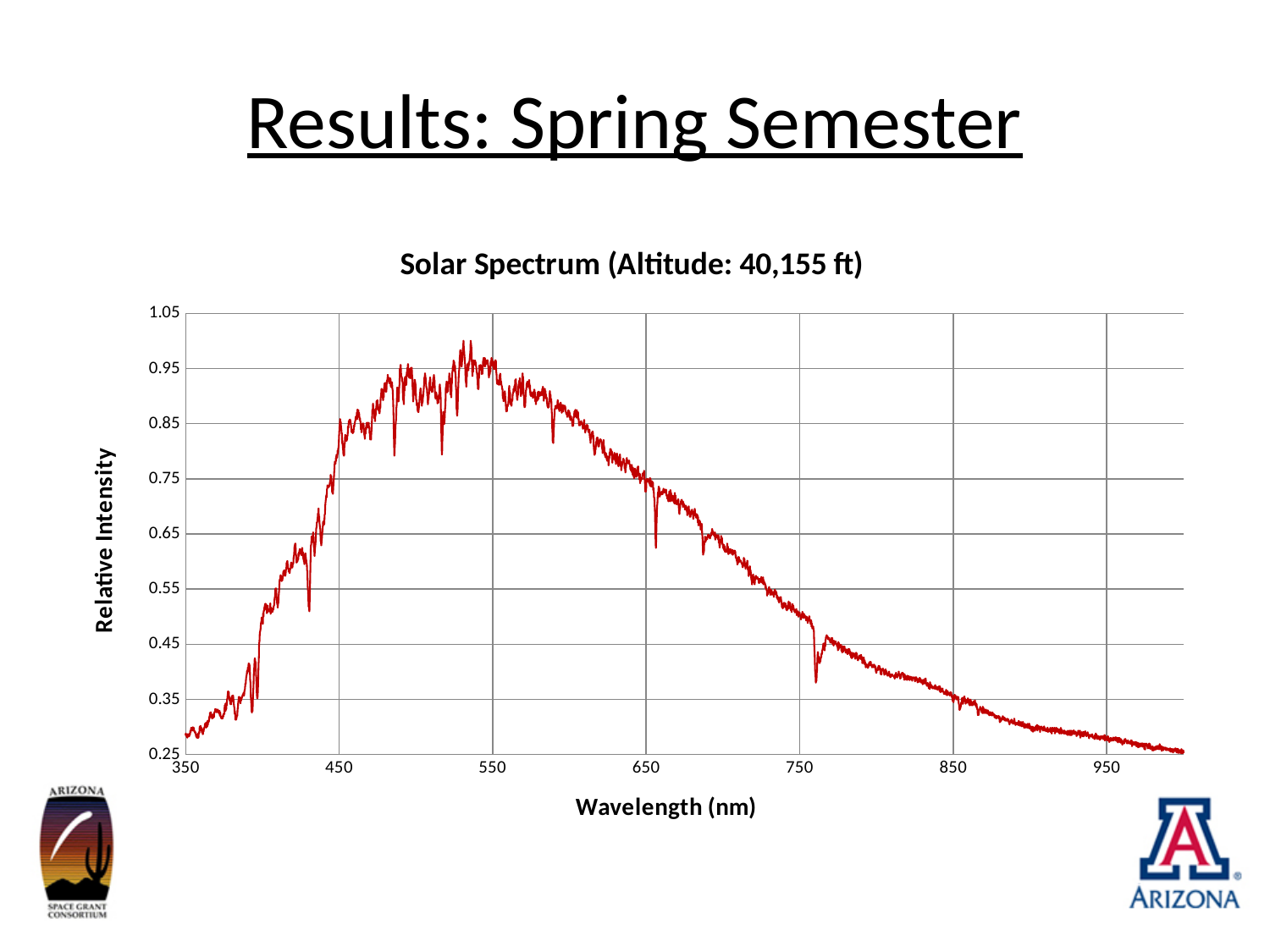
Does the relative intensity rise or fall as wavelength increases from 550 nm to 1000 nm? fall Is the relative intensity at 650 nm greater or less than 0.65? greater What kind of chart is shown on the slide? line chart What is the label of the x axis of the chart? Wavelength (nm) What is the title of the chart? Solar Spectrum (Altitude: 40,155 ft) Is the peak relative intensity on the chart greater or less than 0.95? greater Is the relative intensity at 950 nm greater or less than 0.35? less Does the relative intensity rise or fall as wavelength increases from 350 nm to 450 nm? rise Is the relative intensity higher at 550 nm or at 850 nm? 550 nm